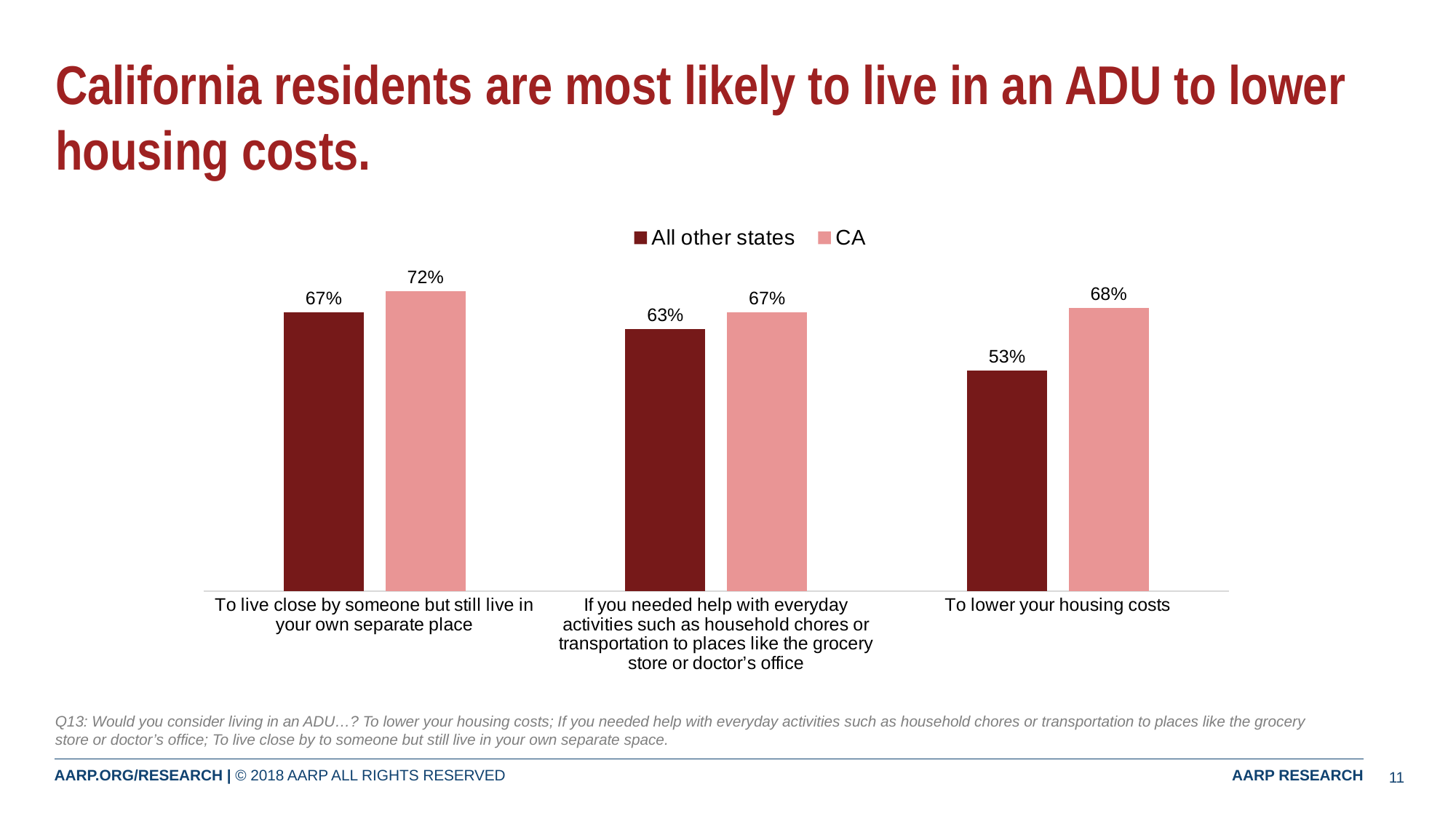
How many series does the legend list? 2 What is the value for All other states for "To lower your housing costs"? 53% What is the value for CA for "To lower your housing costs"? 68% How many categories are shown on the x axis? 3 What is the difference between the CA and All other states values for "To lower your housing costs"? 15 percentage points What is the value for CA for "To live close by someone but still live in your own separate place"? 72% What is the value for All other states for "If you needed help with everyday activities such as household chores or transportation to places like the grocery store or doctor's office"? 63% What kind of chart is shown on the slide? Bar chart What is the difference between the CA and All other states values for "To live close by someone but still live in your own separate place"? 5 percentage points Which category has the lowest value for All other states? To lower your housing costs Which category has the highest value for CA? To live close by someone but still live in your own separate place For "To lower your housing costs", which is larger: the CA value or the All other states value? CA